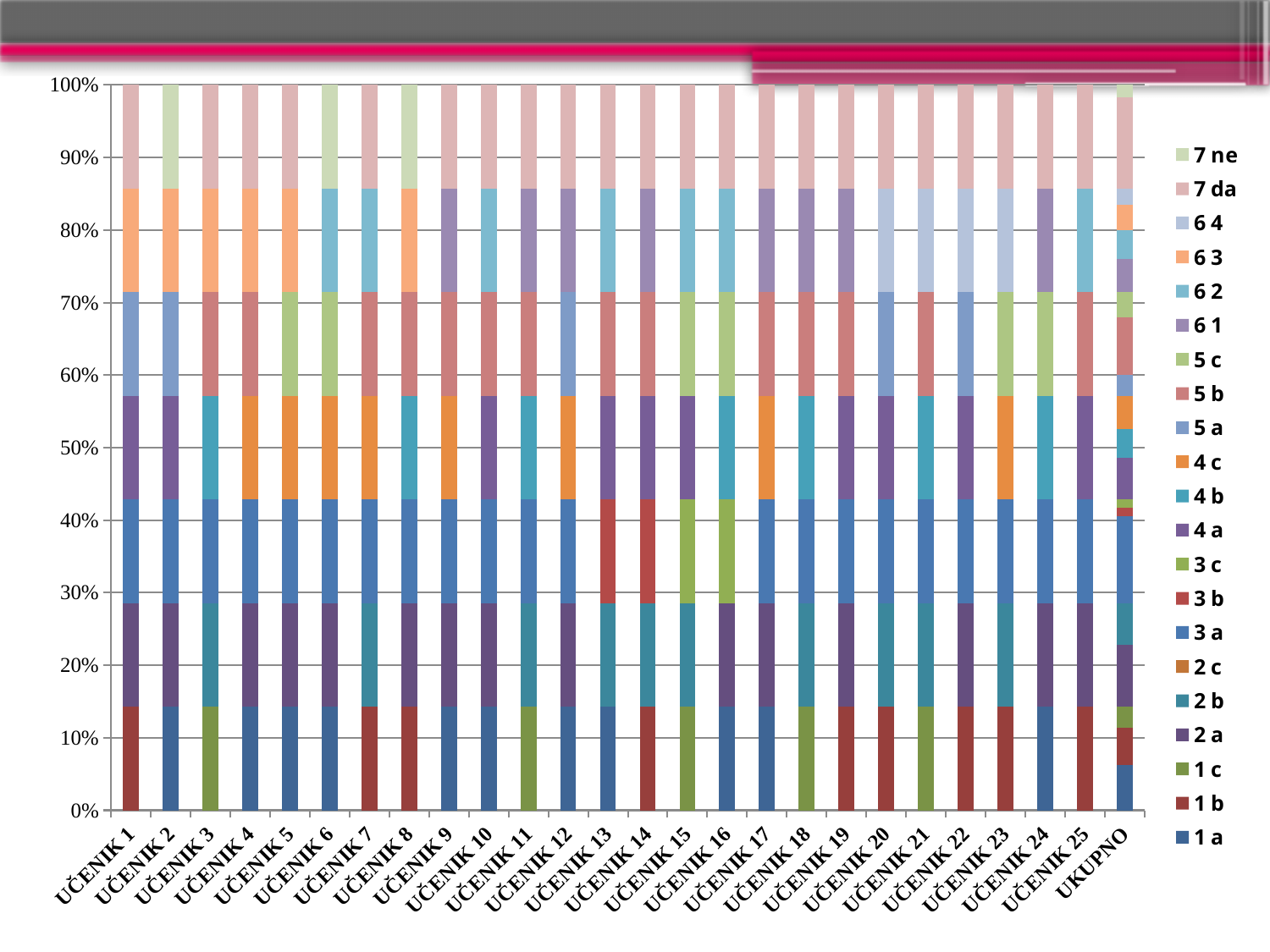
What kind of chart is shown on the slide? Stacked bar chart Is the value of the 1 b segment for UČENIK 1 greater or less than 10%? greater What is the highest value shown on the y axis? 100% How many series does the chart's legend list? 21 Is the value of the 1 b segment for UČENIK 1 greater or less than 20%? less Is the value of the 3 a segment for UKUPNO greater or less than 10%? greater What is the label of the last category on the x axis? UKUPNO How many categories are shown along the x axis of the chart? 26 How many categories are labelled UČENIK followed by a number? 25 Which category's bar is made up of the most segments? UKUPNO